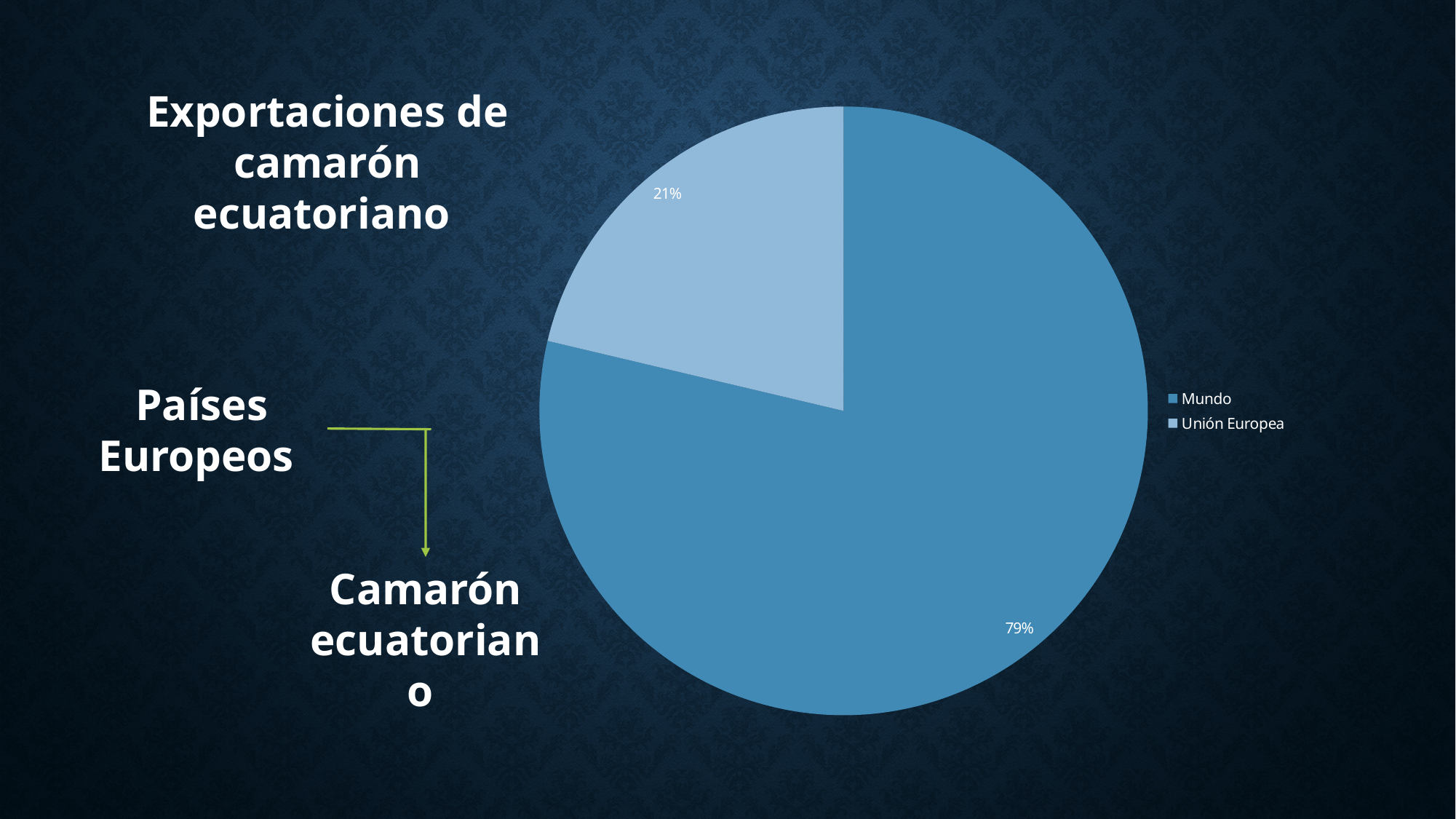
What is the difference in percentage points between the Mundo slice and the Unión Europea slice? 58 Which is larger, the Mundo slice or the Unión Europea slice? Mundo What is the total of the two percentages shown on the pie chart? 100% What share of the pie does Mundo represent? 79% Which legend entry is shown in the lighter blue colour? Unión Europea Which slice of the pie is the smallest? Unión Europea What is the title text shown to the left of the pie chart at the top of the slide? Exportaciones de camarón ecuatoriano What share of the pie does Unión Europea represent? 21% Which slice of the pie is the largest? Mundo What kind of chart is shown on the slide? pie chart How many slices does the pie chart have? 2 How many entries does the legend list? 2